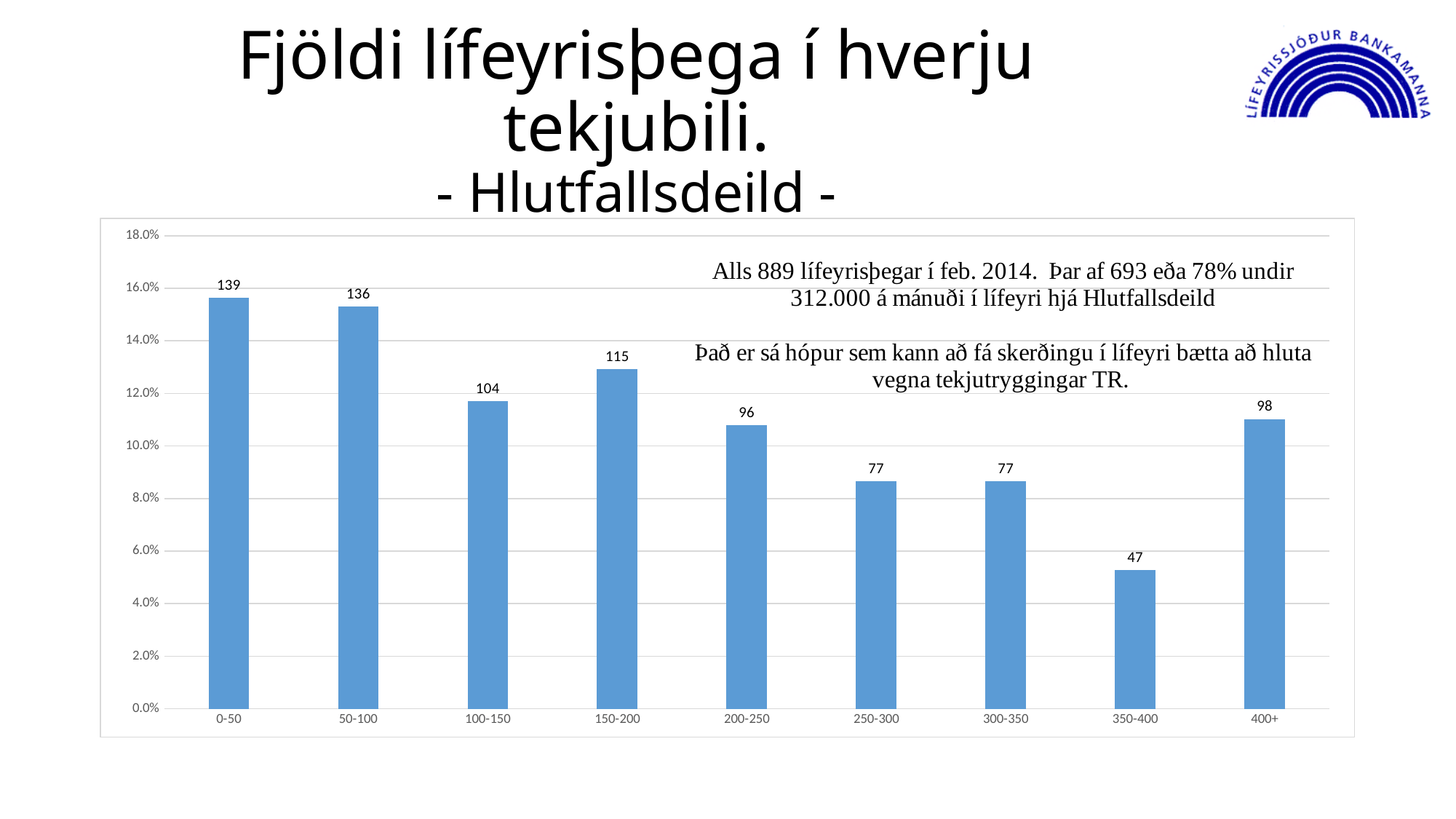
How many categories are shown on the x axis? 9 What is the data label shown on the bar for the 0-50 category? 139 What is the data label shown on the bar for the 350-400 category? 47 What is the data label shown on the bar for the 400+ category? 98 Which category has the lowest bar? 350-400 What kind of chart is shown on the slide? Bar chart Is the bar for 350-400 greater or less than 6.0% on the y axis? less Which has the larger data label, 100-150 or 150-200? 150-200 What is the difference between the data labels for 0-50 and 50-100? 3 Which category has the highest bar? 0-50 Is the bar for 200-250 greater or less than 10.0% on the y axis? greater What is the difference between the data labels for 150-200 and 350-400? 68